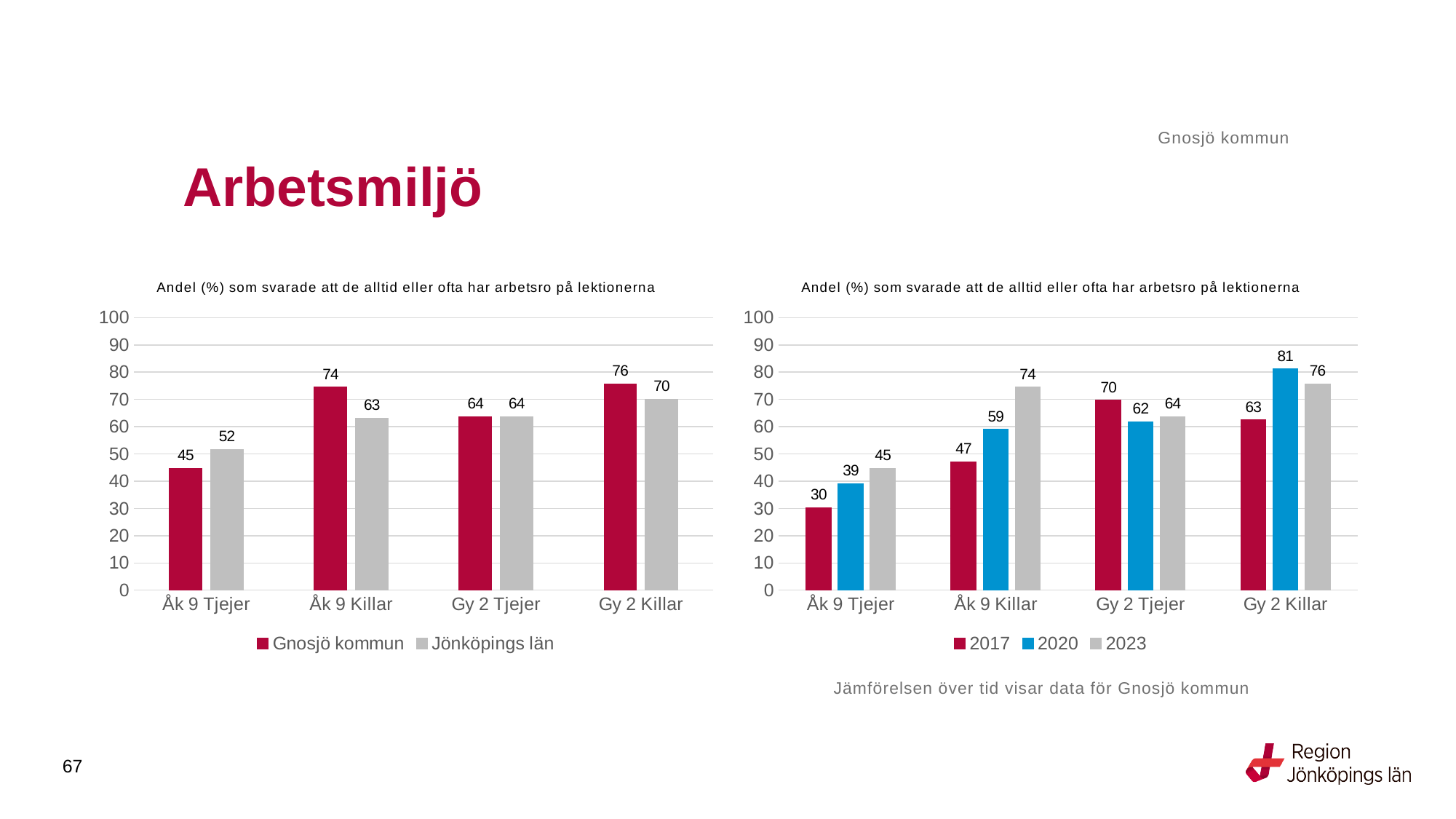
In the right chart, what is the difference between the 2023 and 2017 values for Åk 9 Killar? 27 In the right chart, which is larger for Gy 2 Tjejer: the 2017 value or the 2020 value? 2017 In the left chart, which category has the highest value for Gnosjö kommun? Gy 2 Killar What kind of chart is the right chart? Bar chart In the left chart, what is the value for Jönköpings län for Åk 9 Tjejer? 52 In the left chart, what is the difference between Gnosjö kommun and Jönköpings län for Åk 9 Killar? 11 In the left chart, what is the value for Gnosjö kommun for Åk 9 Killar? 74 In the right chart, what is the value for 2017 for Åk 9 Tjejer? 30 In the right chart, what is the value for 2020 for Gy 2 Killar? 81 In the left chart, how many series does the legend list? 2 In the right chart, which category has the lowest value for 2023? Åk 9 Tjejer In the right chart, how many categories are shown on the x axis? 4